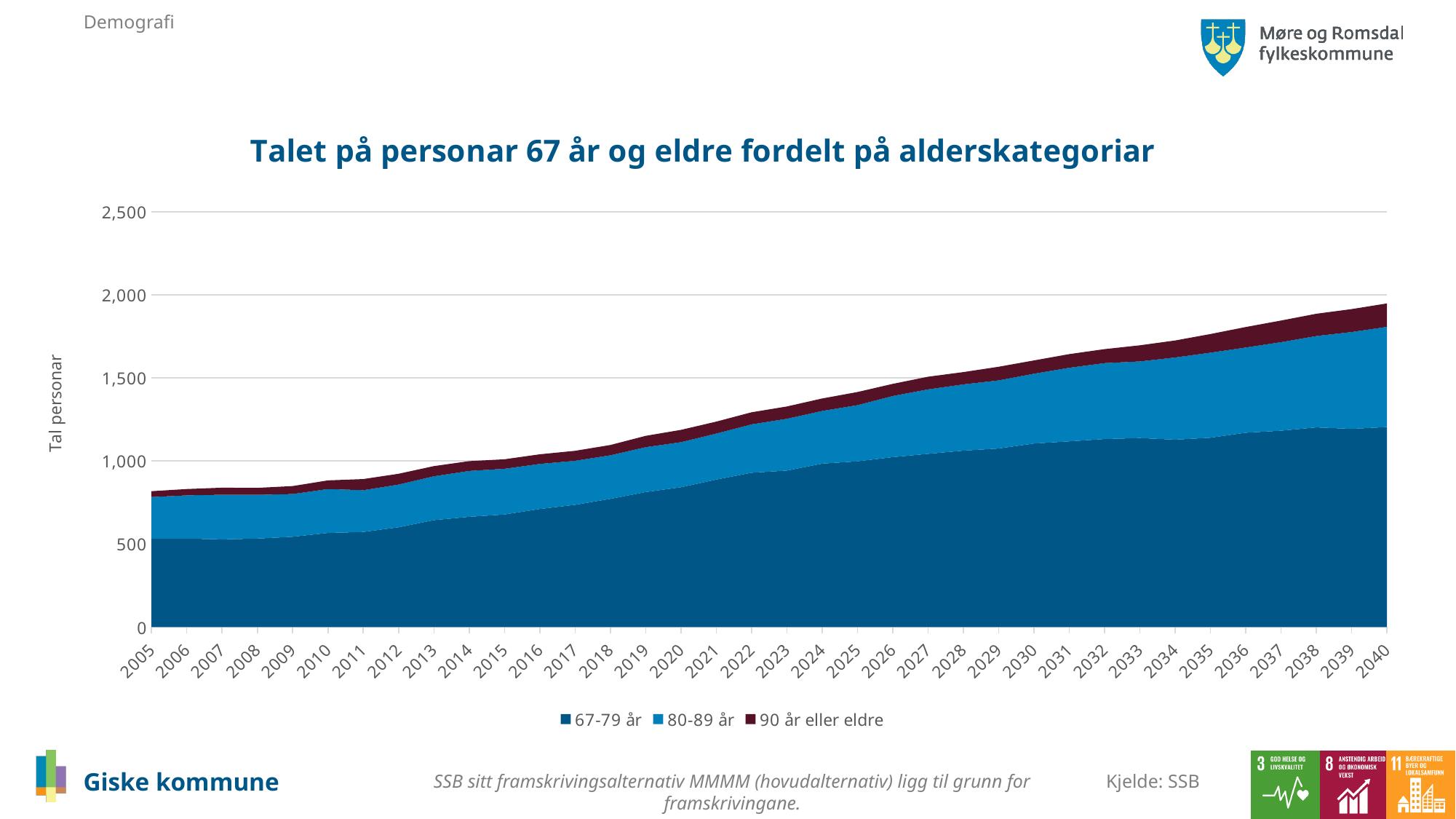
Is the total value for 2005 greater or less than 1,000? less Is the total value for 2040 greater or less than 1,500? greater What is the title of the chart? Talet på personar 67 år og eldre fordelt på alderskategoriar What is the label on the y axis? Tal personar Is the total value for 2010 greater or less than 1,000? less What kind of chart is shown on the slide? Stacked area chart Which age category is the largest in 2040? 67-79 år How many years are shown along the x axis? 36 Does the total number of persons 67 år og eldre rise or fall from 2005 to 2040? Rise How many series does the legend list? 3